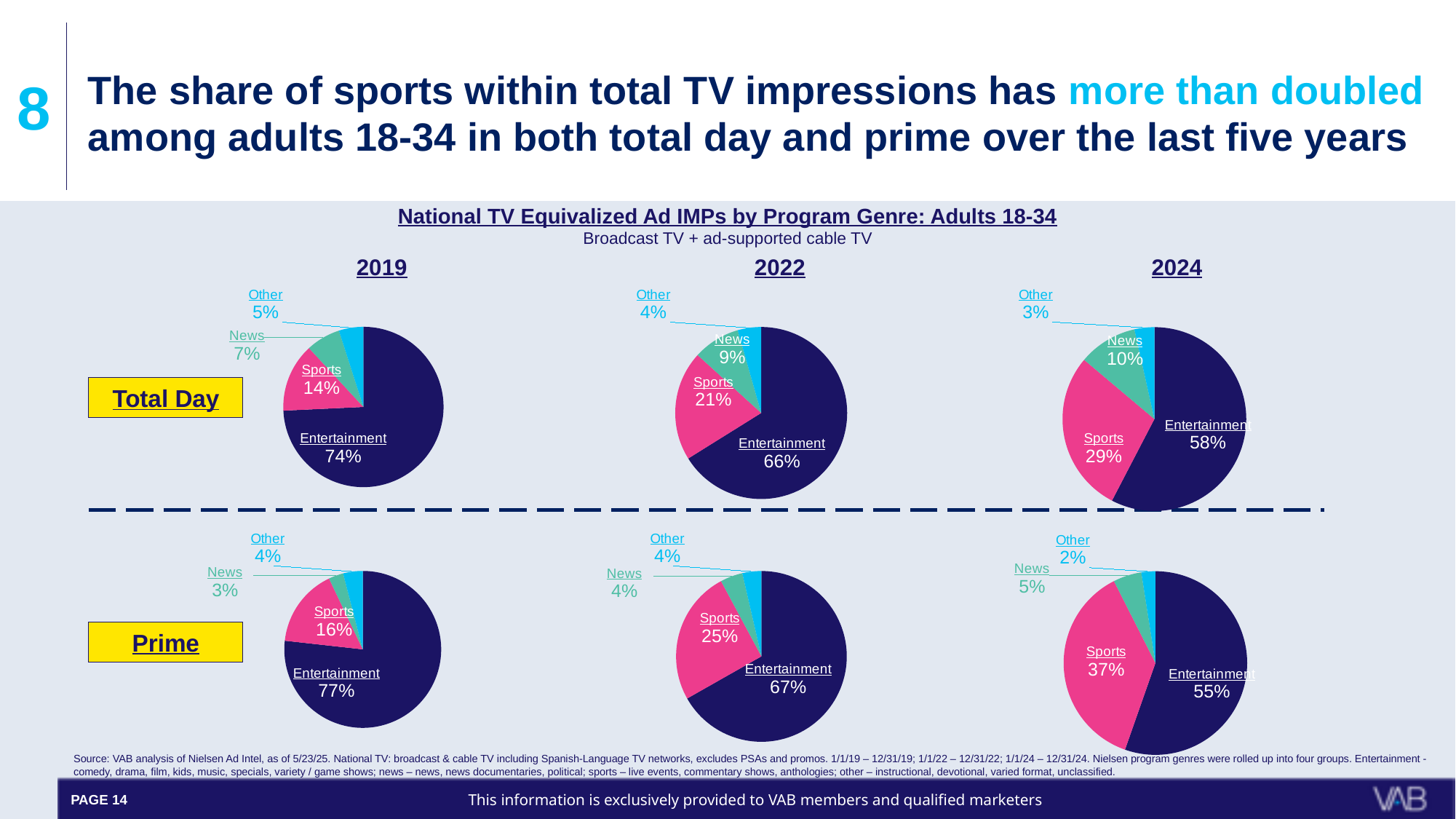
What is the difference between the Sports share in the Total Day 2024 pie chart and the Sports share in the Total Day 2019 pie chart? 15% In the Total Day 2024 pie chart, what share does Entertainment have? 58% Across the Prime pie charts from 2019 to 2024, does the Sports share rise or fall? Rise How many slices does the Total Day 2019 pie chart have? 4 In the Prime 2024 pie chart, which genre has the smallest share? Other In the Prime 2022 pie chart, what share does News have? 4% Which is larger: the Sports share in the Prime 2024 pie chart or the Sports share in the Total Day 2024 pie chart? Prime 2024 How many pie charts are shown on the slide? 6 What type of chart is used to show the Prime 2022 data? Pie chart In the Total Day 2022 pie chart, which genre has the largest share? Entertainment In the Total Day 2019 pie chart, what share does Sports have? 14% In the Prime 2024 pie chart, what share does Sports have? 37%